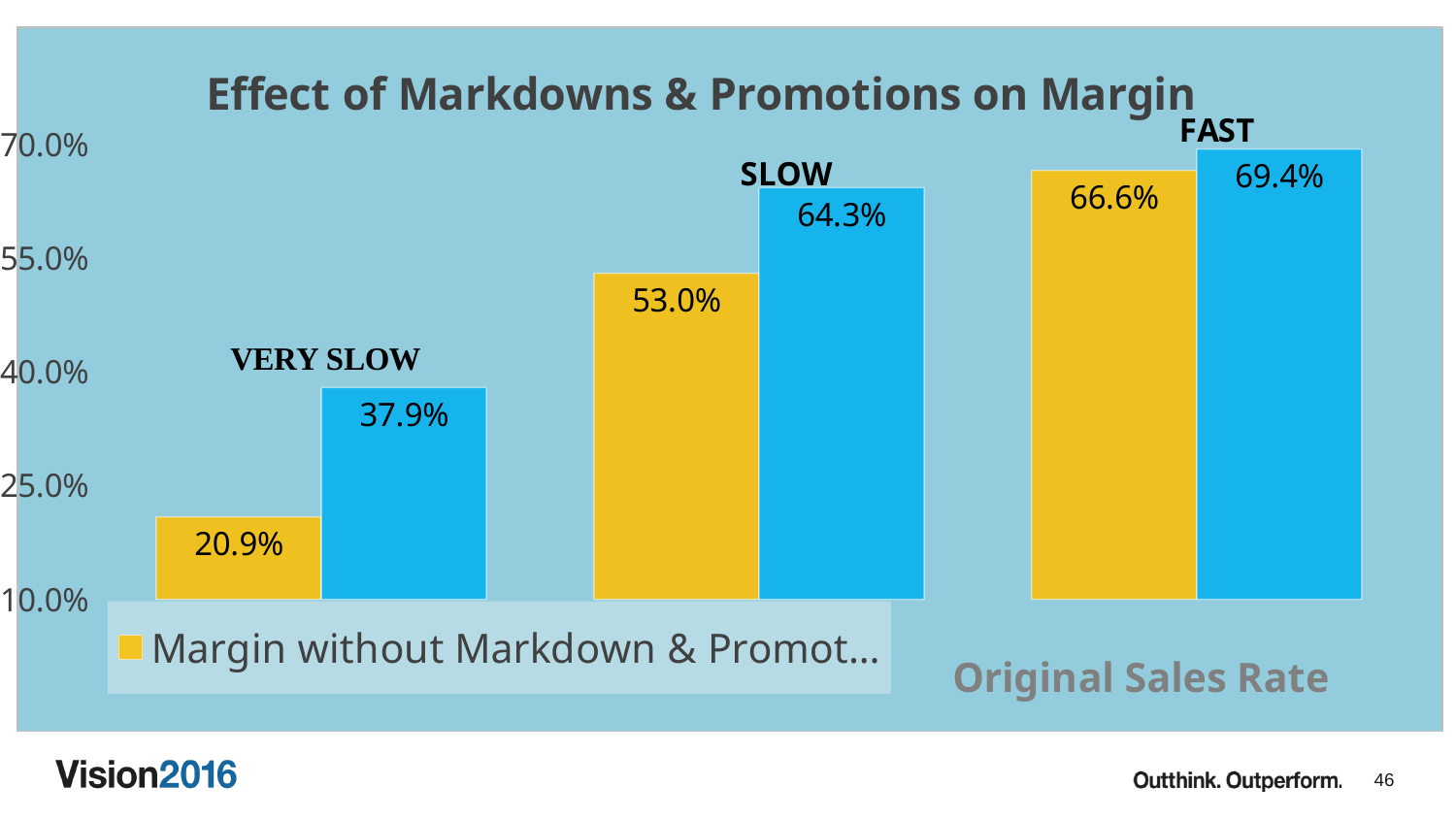
What is the title of the chart? Effect of Markdowns & Promotions on Margin What is the value of the yellow bar (Margin without Markdown & Promotions) for FAST? 66.6% What is the difference between the blue bar and the yellow bar for VERY SLOW? 17.0% Which is larger for SLOW: the yellow bar or the blue bar? the blue bar Which category has the highest blue bar value? FAST How many categories are shown on the x axis? 3 Do the yellow bar values rise or fall from VERY SLOW to FAST? rise What is the value of the blue bar for VERY SLOW? 37.9% What is the value of the yellow bar (Margin without Markdown & Promotions) for VERY SLOW? 20.9% What type of chart is shown on the slide? bar chart Which category has the lowest yellow bar (Margin without Markdown & Promotions) value? VERY SLOW What is the value of the blue bar for SLOW? 64.3%